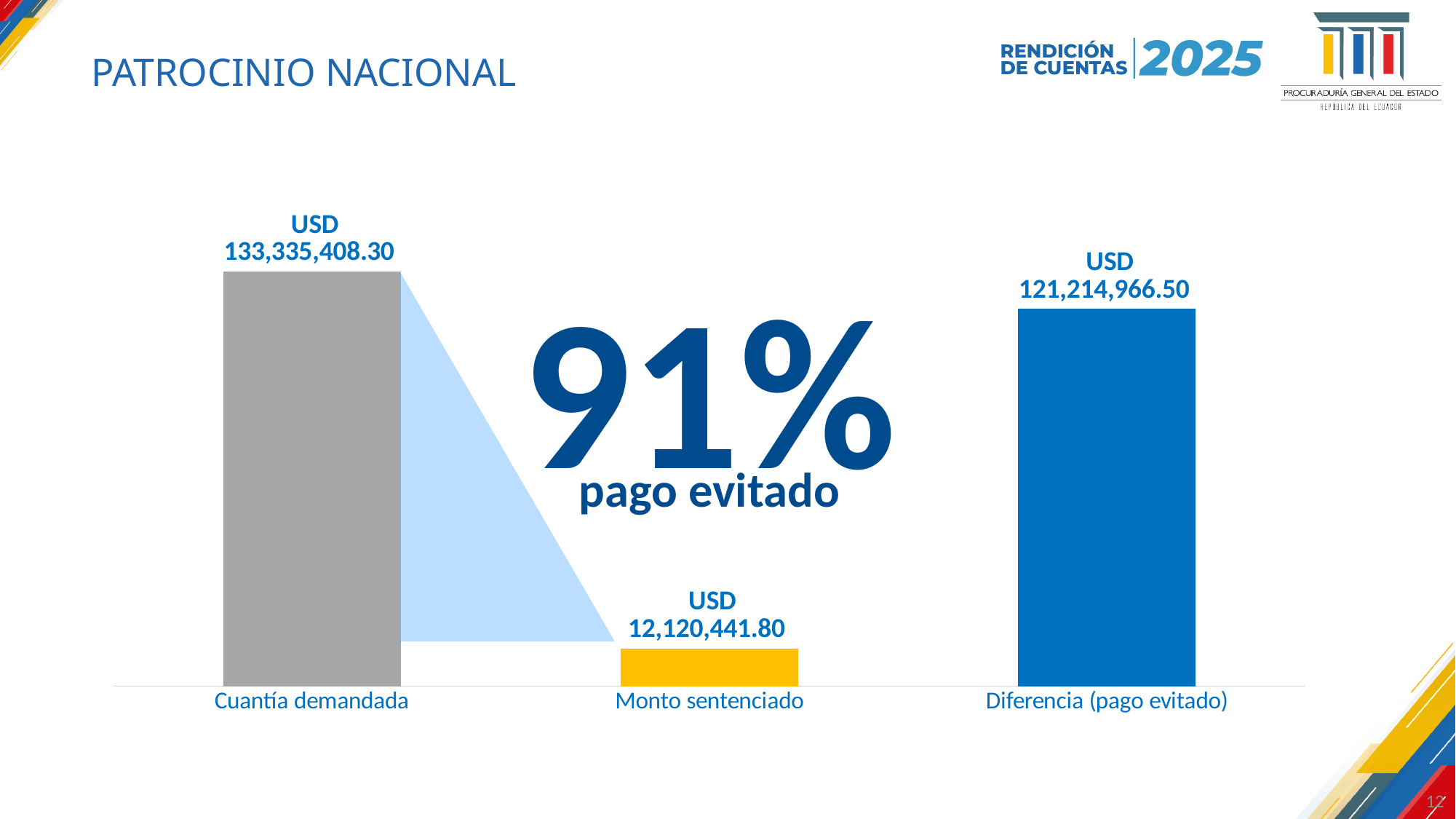
Which category has the lowest value? Monto sentenciado What is the difference between Cuantía demandada and Monto sentenciado? USD 121,214,966.50 Which is larger, Monto sentenciado or Diferencia (pago evitado)? Diferencia (pago evitado) What percentage is shown as 'pago evitado' in the middle of the chart? 91% What kind of chart is shown on the slide? Bar chart What is the value for Monto sentenciado? USD 12,120,441.80 What is the difference between Cuantía demandada and Diferencia (pago evitado)? USD 12,120,441.80 Which category has the highest value? Cuantía demandada What is the value for Cuantía demandada? USD 133,335,408.30 What is the value for Diferencia (pago evitado)? USD 121,214,966.50 What colour is the bar for Monto sentenciado? Yellow How many categories are shown in the chart? 3